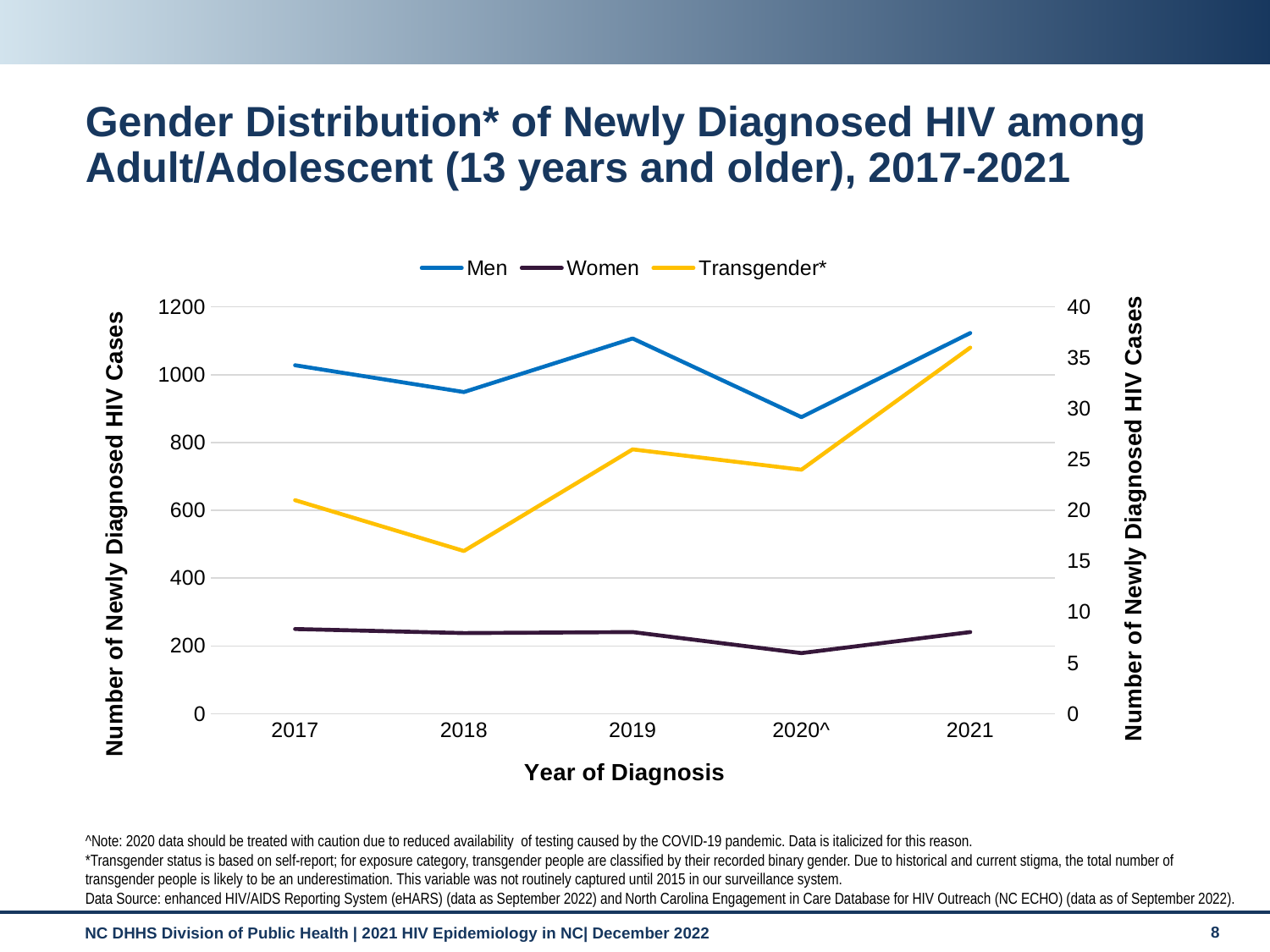
How many series does the legend list? 3 Does the Men line rise or fall from 2019 to 2020^? fall What colour is the Transgender* line in the legend? yellow In which year is the Transgender* line at its highest? 2021 Which series has the larger value in 2021, Men or Women? Men In which year is the Women line at its lowest? 2020^ In which year is the Men line at its lowest? 2020^ How many years of diagnosis are plotted along the x axis? 5 In which year is the Transgender* line at its lowest? 2018 Is the value for Men in 2018 greater or less than 1000 on the left axis? less What kind of chart is shown on the slide? line chart Is the value for Women in 2017 greater or less than 400 on the left axis? less